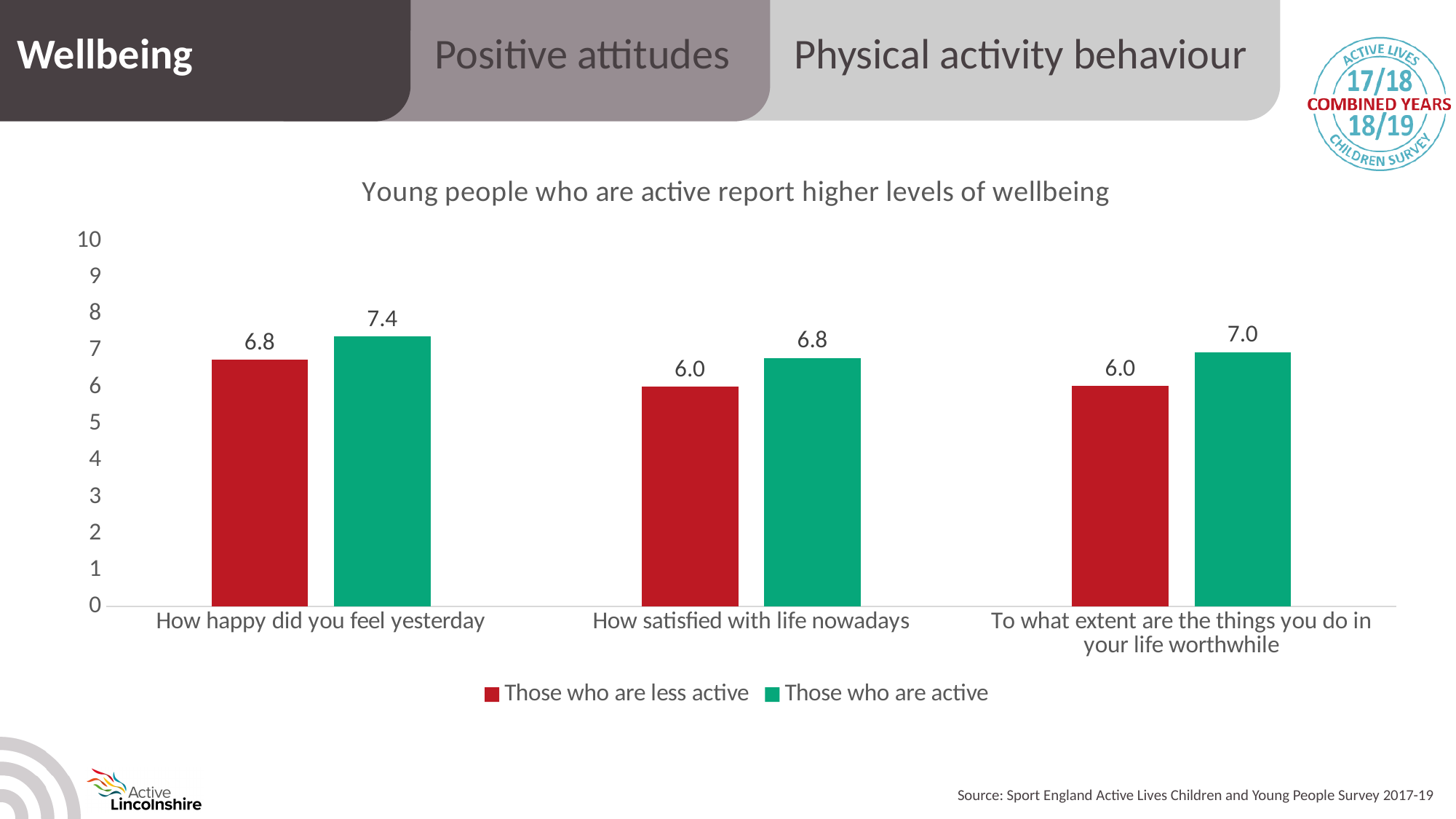
What is the value for 'Those who are active' for 'How happy did you feel yesterday'? 7.4 How many categories are shown on the x axis? 3 What is the difference between 'Those who are active' and 'Those who are less active' for 'How happy did you feel yesterday'? 0.6 Is the value for 'Those who are less active' for 'How happy did you feel yesterday' greater or less than 5? greater For 'To what extent are the things you do in your life worthwhile', which series has the larger value? Those who are active Which category has the lowest value for 'Those who are less active'? How satisfied with life nowadays and To what extent are the things you do in your life worthwhile (both 6.0) What is the value for 'Those who are active' for 'To what extent are the things you do in your life worthwhile'? 7.0 What kind of chart is shown on the slide? Bar chart Which category has the highest value for 'Those who are active'? How happy did you feel yesterday What is the difference between 'Those who are active' and 'Those who are less active' for 'How satisfied with life nowadays'? 0.8 What is the value for 'Those who are less active' for 'How satisfied with life nowadays'? 6.0 How many series does the legend list? 2